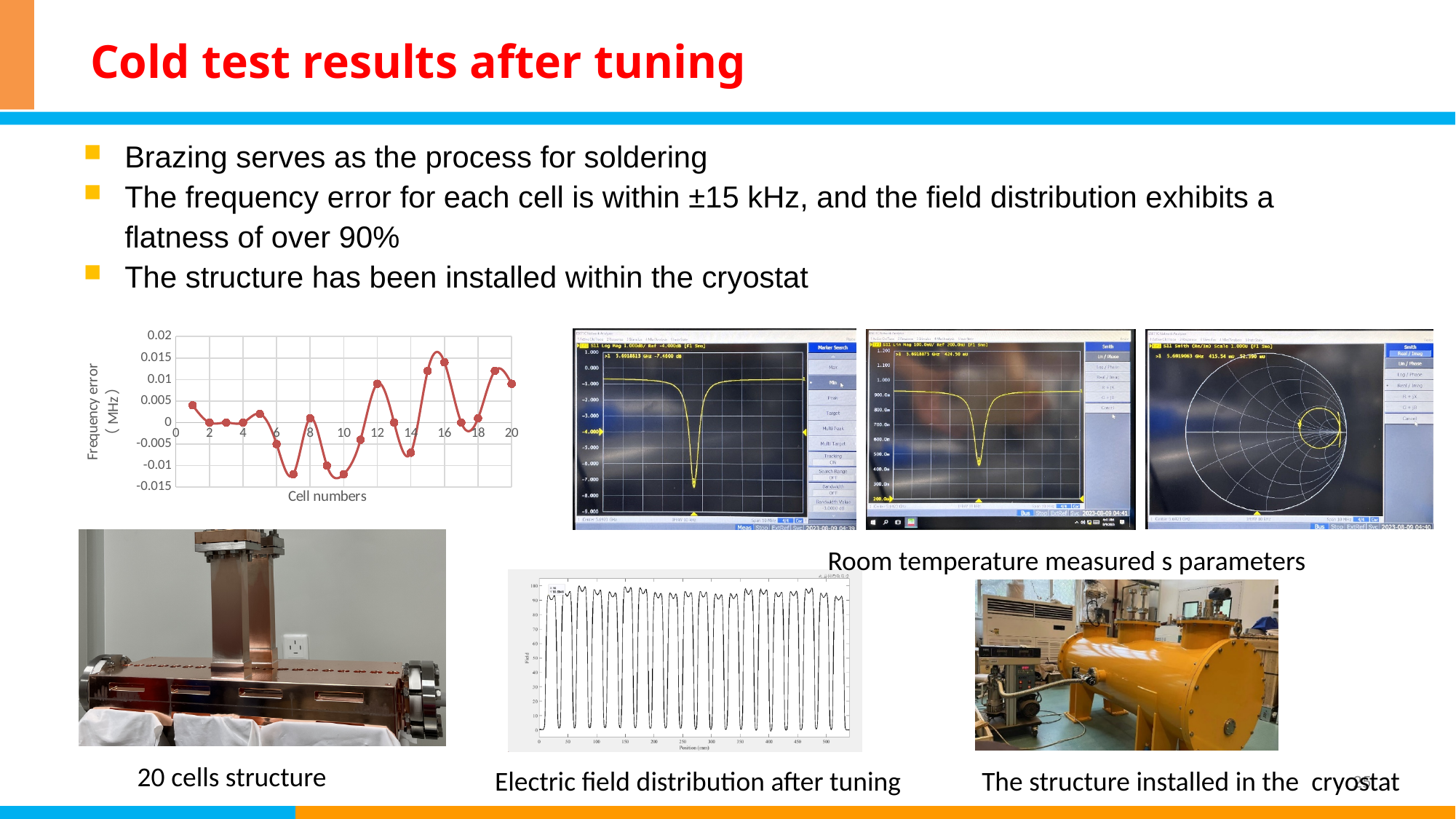
In the frequency error chart, is the value for cell 16 greater or less than 0.01? greater In the frequency error chart, which has the larger value, cell 12 or cell 14? cell 12 How many data points are plotted in the frequency error chart? 20 In the frequency error chart, is the value for cell 12 greater or less than 0.005? greater In the frequency error chart, is the value for cell 14 greater or less than -0.005? less What kind of chart is the 'Frequency error' vs 'Cell numbers' chart on the left of the slide? line chart In the frequency error chart, what is the label of the x axis? Cell numbers In the frequency error chart, what is the label of the y axis? Frequency error (MHz) In the frequency error chart, which has the larger value, cell 16 or cell 7? cell 16 In the frequency error chart, which cell number has the highest frequency error? 16